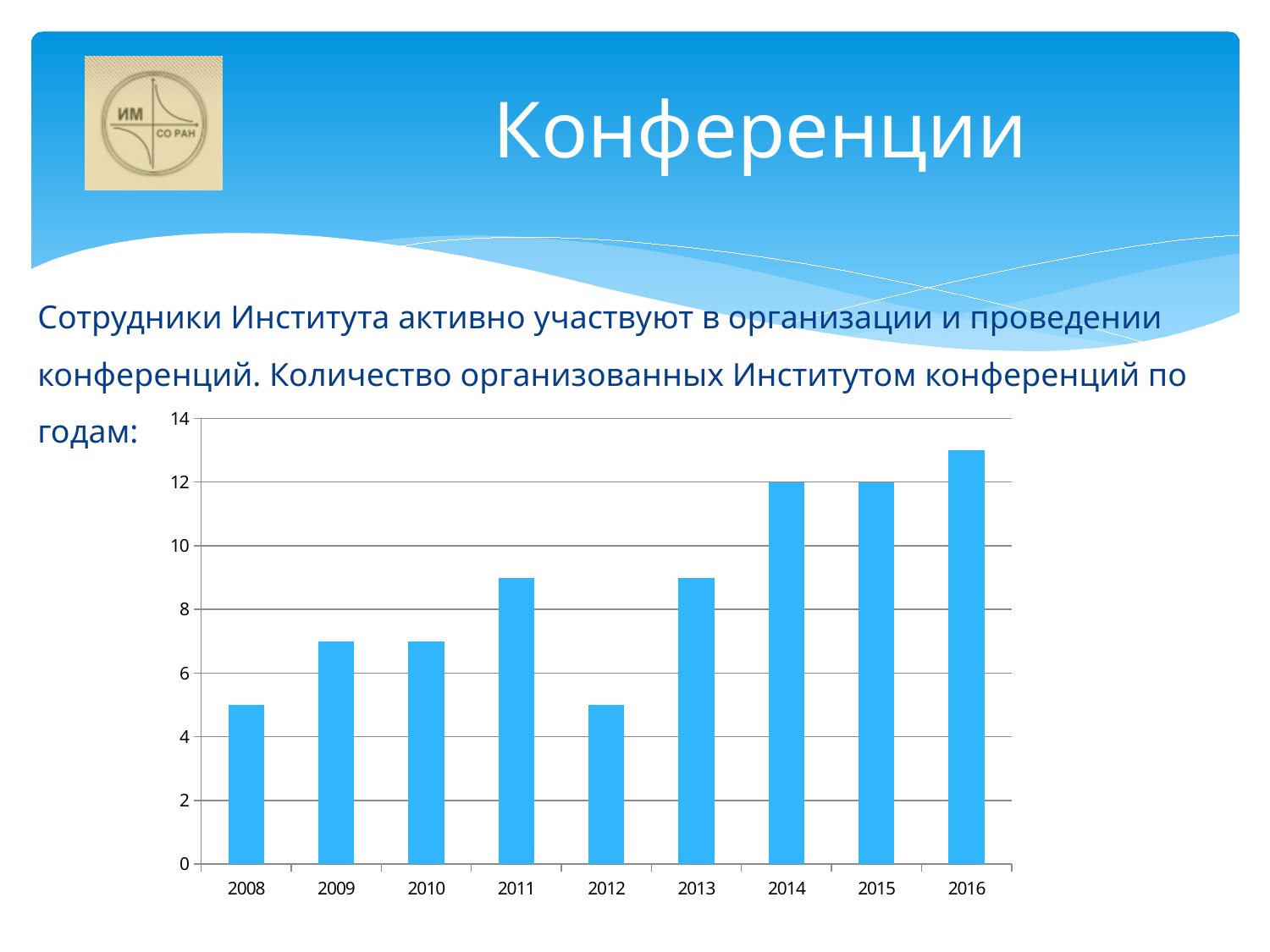
Which is larger, the value for 2009 or the value for 2014? 2014 Which year has the highest value? 2016 Is the value for 2012 greater or less than 4? greater What kind of chart is shown on the slide? bar chart How many years are shown on the x axis of the chart? 9 Do the values generally rise or fall from 2008 to 2016? rise What is the value for 2015? 12 Is the value for 2008 greater or less than 6? less Which is larger, the value for 2011 or the value for 2012? 2011 Is the value for 2011 greater or less than 8? greater What is the value for 2014? 12